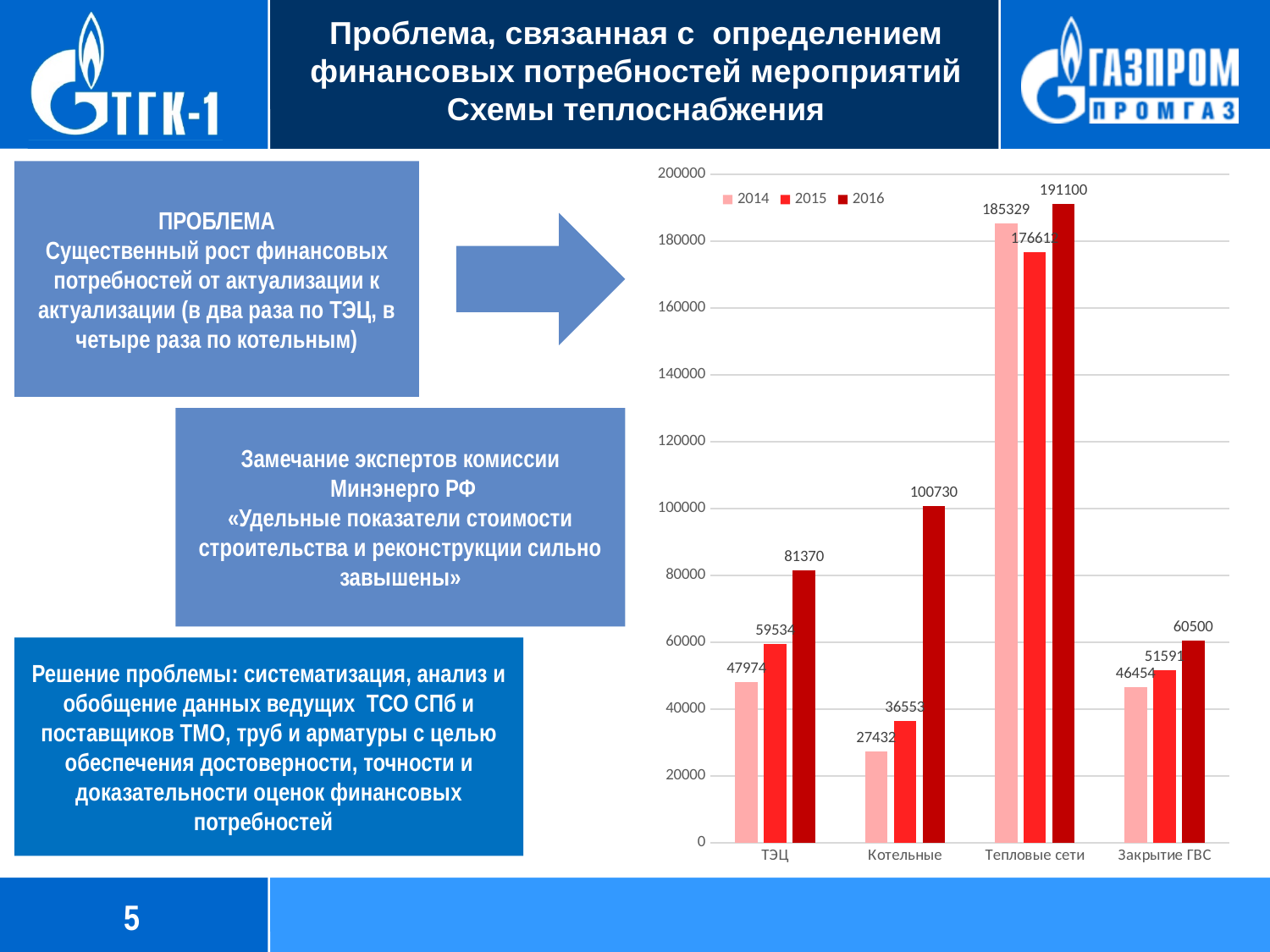
Which is larger: the 2014 value for ТЭЦ or the 2014 value for Закрытие ГВС? ТЭЦ How many categories are shown on the x axis of the chart? 4 What is the difference between the 2016 and 2014 values for Котельные? 73298 What is the value for Закрытие ГВС in 2015? 51591 How many series does the chart legend list? 3 Do the values for Котельные rise or fall from 2014 to 2016? rise What is the value for Тепловые сети in 2016? 191100 Which category has the lowest value in 2014? Котельные What is the value for ТЭЦ in 2016? 81370 What is the value for Котельные in 2014? 27432 Which category has the highest value in 2016? Тепловые сети What type of chart is shown on the slide? bar chart